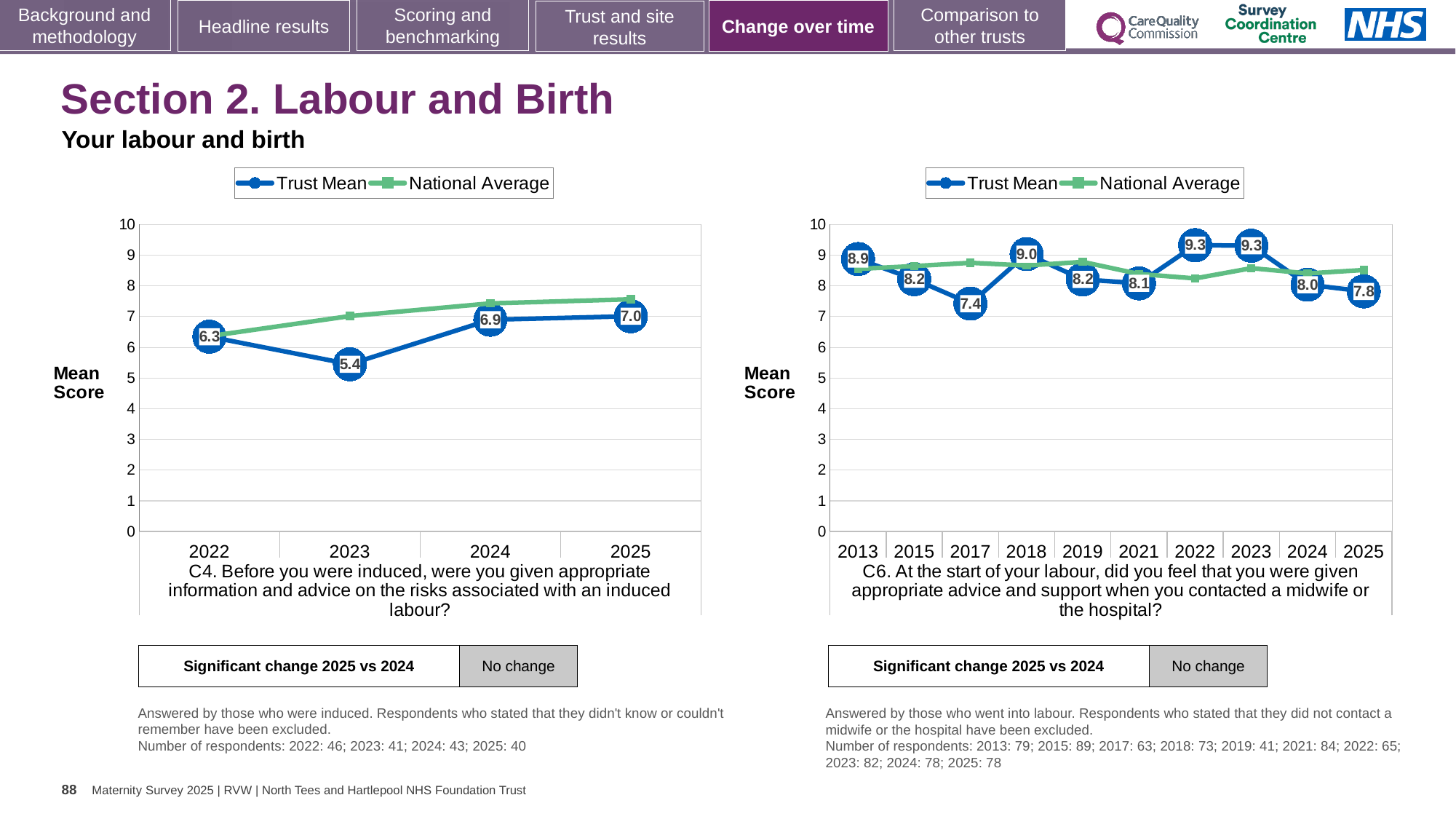
In the left chart (C4), which year has the lowest Trust Mean? 2023 In the right chart (C6), which year has the lowest Trust Mean? 2017 In the left chart (C4), is the National Average for 2025 greater or less than 7? greater In the left chart (C4), what is the Trust Mean for 2023? 5.4 In the right chart (C6), what is the Trust Mean for 2017? 7.4 In the right chart (C6), which is larger, the Trust Mean for 2018 or for 2024? 2018 In the left chart (C4), how many years are shown on the x axis? 4 In the left chart (C4), what is the Trust Mean for 2025? 7.0 In the right chart (C6), what is the difference between the Trust Mean in 2023 and in 2025? 1.5 In the left chart (C4), what is the difference between the Trust Mean in 2024 and in 2023? 1.5 What type of chart is the right chart (C6)? Line chart In the right chart (C6), how many series does the legend list? 2